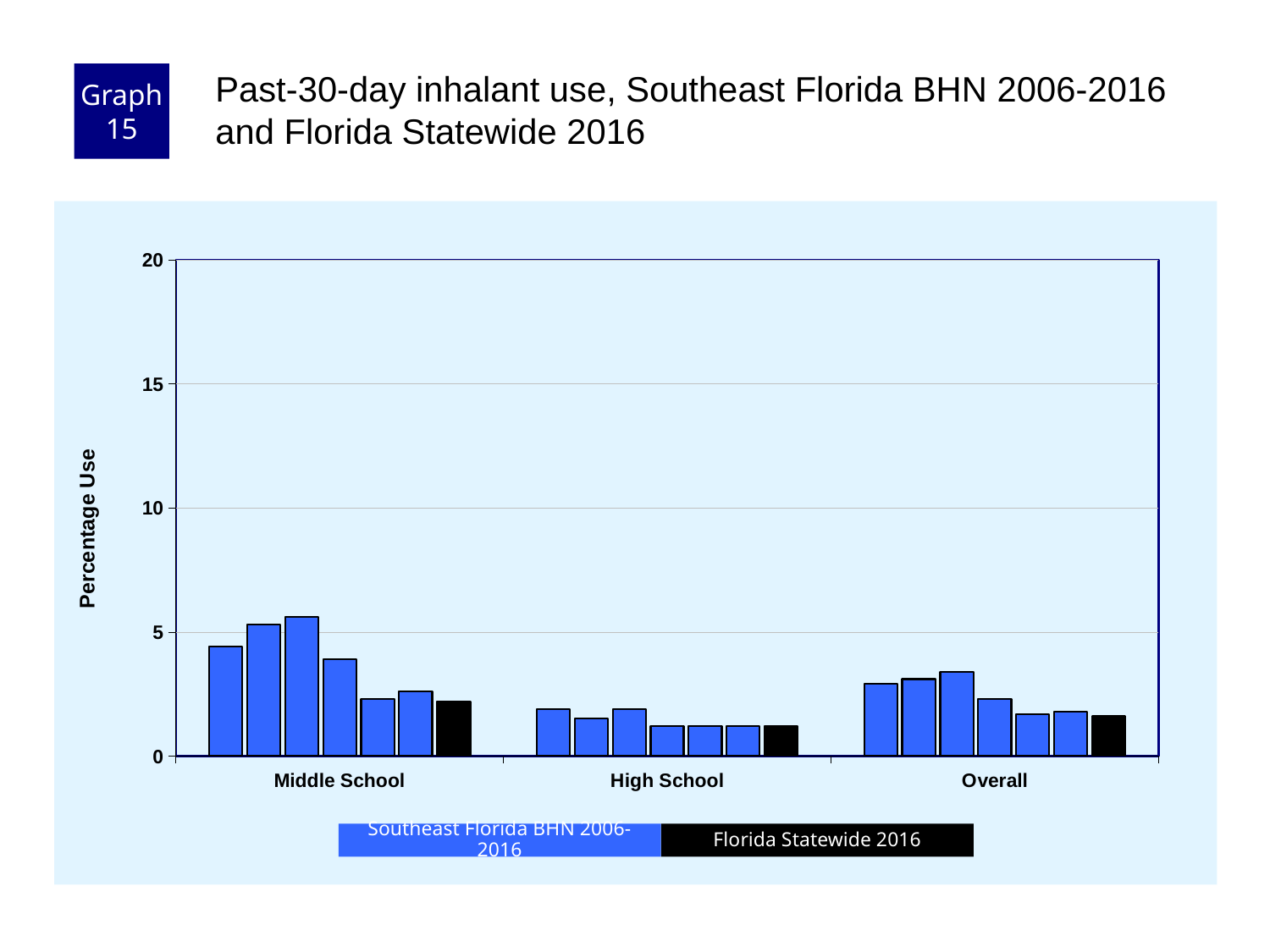
How many series does the legend list? 2 Are all the bars for Overall greater or less than 5? less What is the label on the y axis? Percentage Use Which colour represents Florida Statewide 2016 in the legend? black Which is larger, the Florida Statewide 2016 value for Overall or for High School? Overall Which category has the lowest Florida Statewide 2016 value? High School What kind of chart is shown on the slide? bar chart How many categories are shown on the x axis? 3 Is the Florida Statewide 2016 value for High School greater or less than 5? less Is the highest Southeast Florida BHN bar for Middle School greater or less than 5? greater Which is larger, the Florida Statewide 2016 value for Middle School or for High School? Middle School